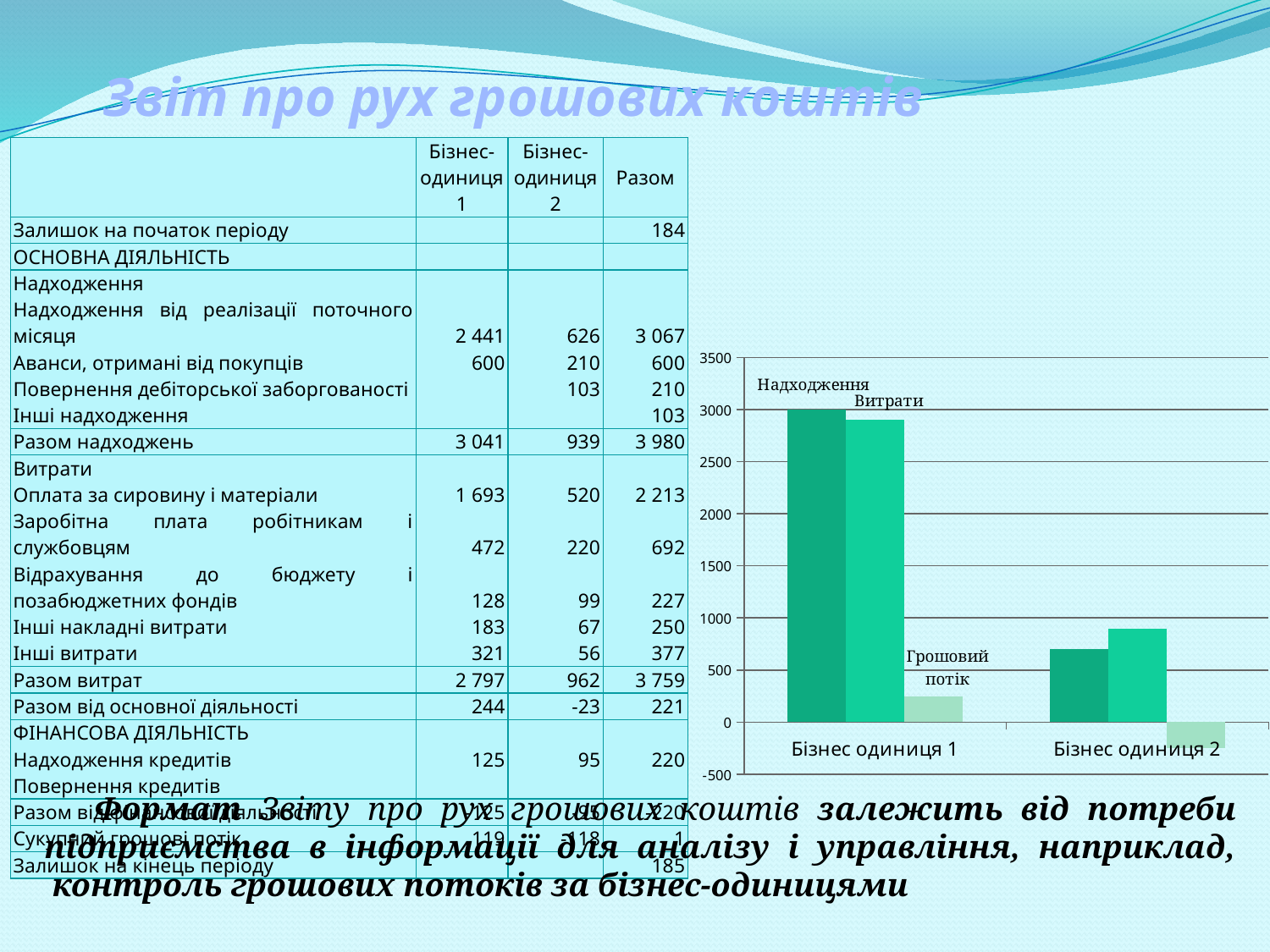
How many categories are shown on the x axis of the chart? 2 Which bar in the chart is the lowest overall? Грошовий потік for Бізнес одиниця 2 What kind of chart is shown on the slide? bar chart How many data series are plotted in the chart? 3 Which category has the higher Надходження bar in the chart? Бізнес одиниця 1 Does the Надходження series rise or fall from Бізнес одиниця 1 to Бізнес одиниця 2? fall Is the Грошовий потік value for Бізнес одиниця 1 greater or less than 500? less Is the Витрати value for Бізнес одиниця 1 greater or less than 3000? less For Бізнес одиниця 1, which is larger: Надходження or Витрати? Надходження Is the Надходження value for Бізнес одиниця 1 greater or less than 2500? greater